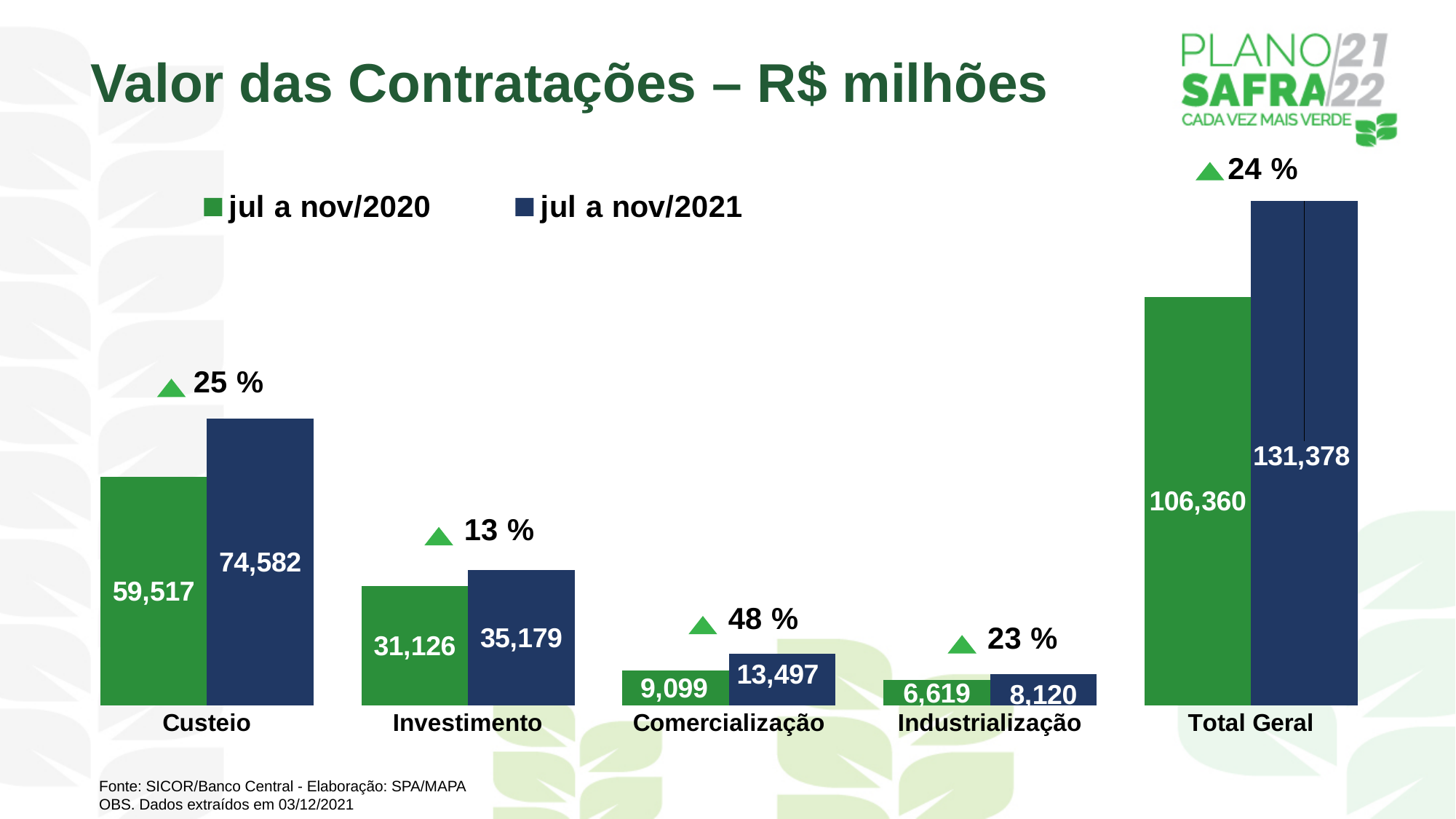
What is the value for Industrialização in the jul a nov/2020 series? 6,619 What is the Total Geral value for jul a nov/2021? 131,378 Excluding Total Geral, which category has the highest value in the jul a nov/2021 series? Custeio What is the difference between the jul a nov/2021 and jul a nov/2020 values for Total Geral? 25,018 Which is larger for Investimento: the jul a nov/2020 value or the jul a nov/2021 value? jul a nov/2021 What is the value for Investimento in the jul a nov/2020 series? 31,126 Excluding Total Geral, which category has the lowest value in the jul a nov/2020 series? Industrialização How many series does the legend list? 2 What is the value for Comercialização in the jul a nov/2021 series? 13,497 What is the difference between the jul a nov/2021 and jul a nov/2020 values for Custeio? 15,065 What is the value for Custeio in the jul a nov/2021 series? 74,582 What percentage increase is shown above the Comercialização bars? 48 %